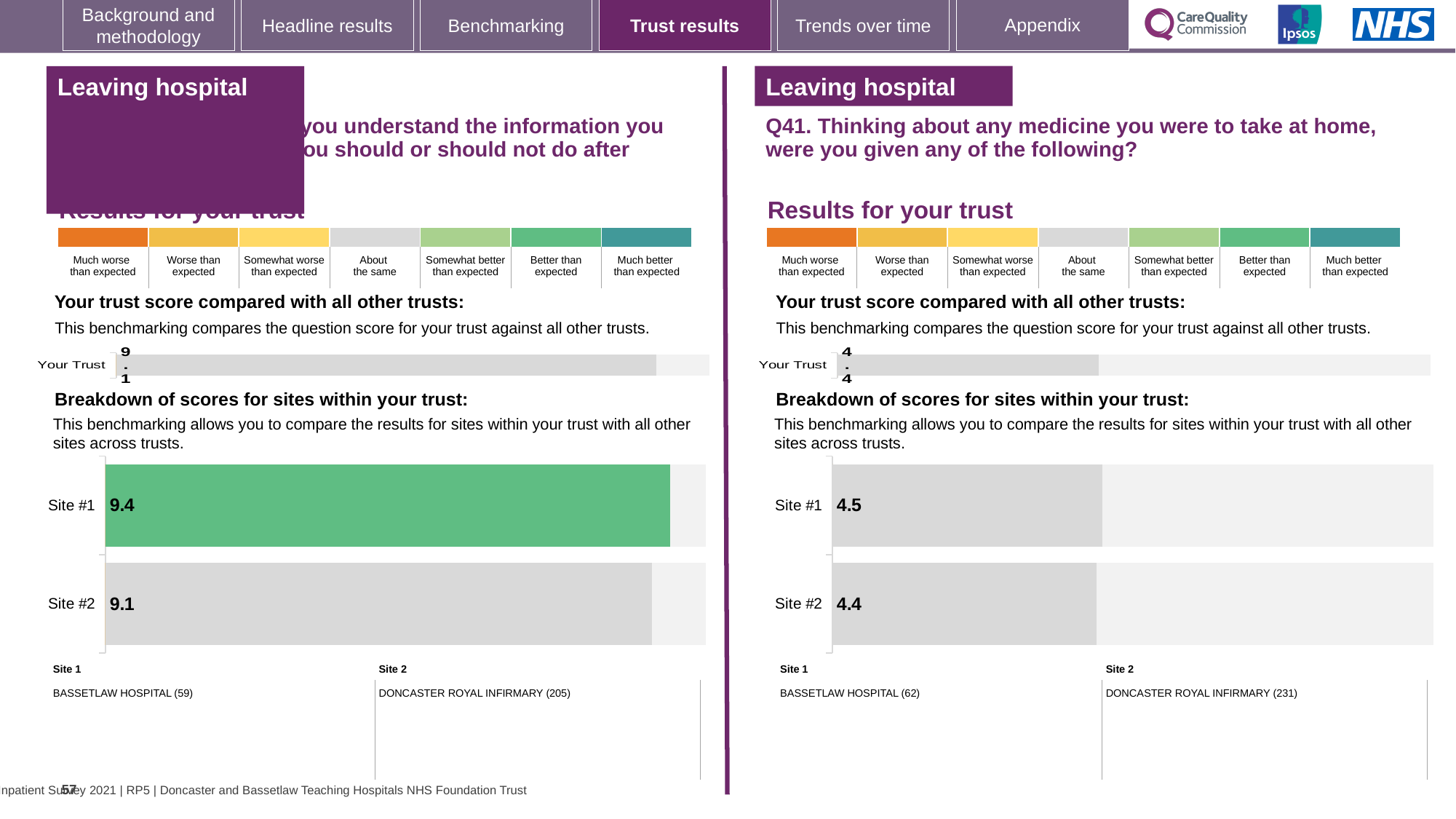
On the right-hand site breakdown chart for Q41, what is the difference between the Site #1 and Site #2 scores? 0.1 On the left-hand chart (breakdown of scores for sites), what is the score for Site #2? 9.1 On the right-hand 'Your Trust' benchmarking bar for Q41, what is the trust score shown? 4.4 On the left-hand 'Your Trust' benchmarking bar, what is the trust score shown? 9.1 On the left-hand site breakdown chart, which site's bar is coloured green? Site #1 What type of chart is used for the breakdown of scores for sites on the right-hand side of the slide? Bar chart How many sites are shown in the site breakdown chart on the left-hand side of the slide? 2 On the left-hand site breakdown chart, which site has the higher score? Site #1 On the left-hand site breakdown chart, what is the difference between the Site #1 and Site #2 scores? 0.3 On the right-hand chart for Q41 (breakdown of scores for sites), what is the score for Site #1? 4.5 On the left-hand chart (breakdown of scores for sites), what is the score for Site #1? 9.4 On the right-hand chart for Q41 (breakdown of scores for sites), what is the score for Site #2? 4.4